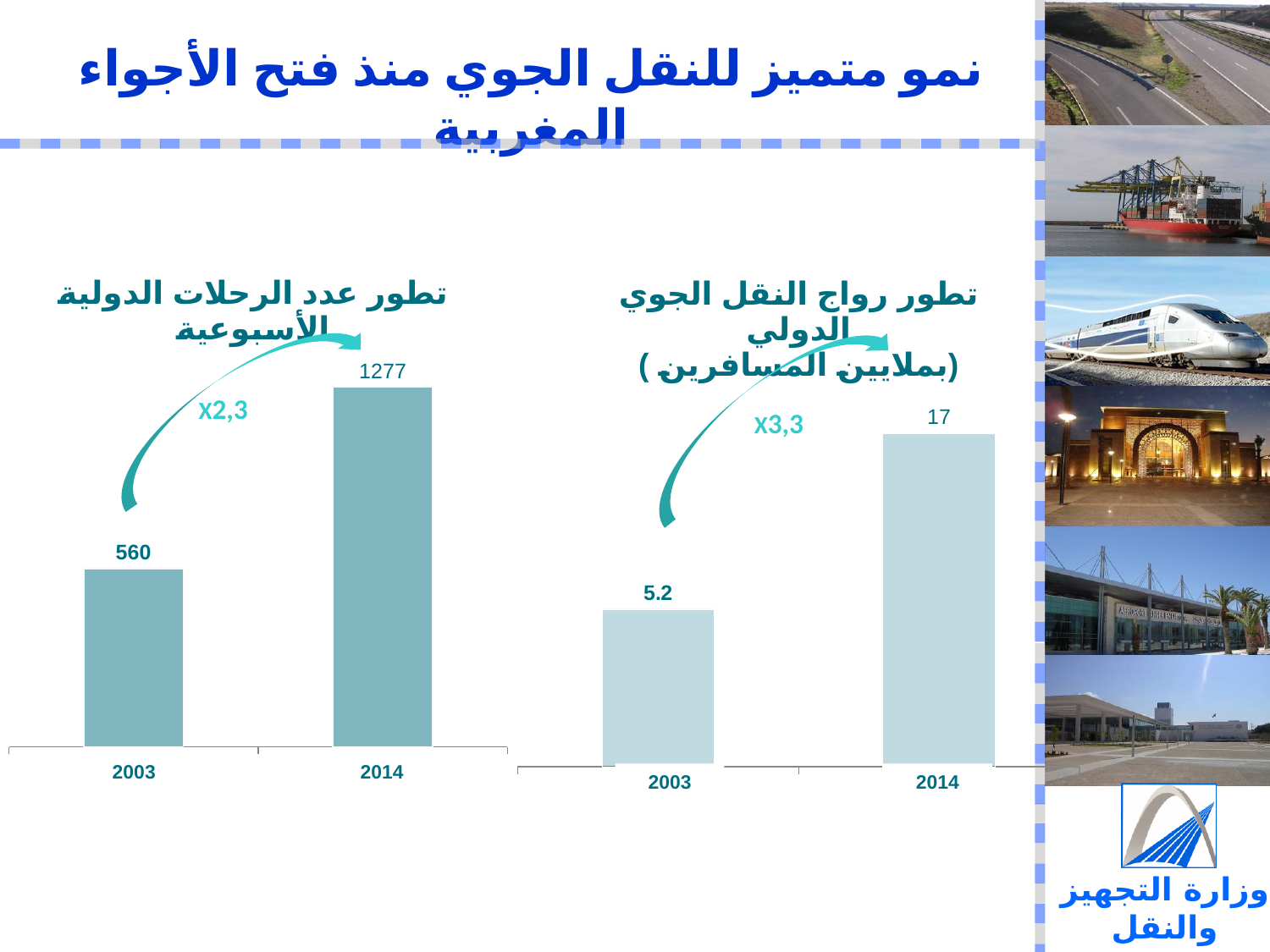
How many bars does the left chart have? 2 What type of chart is the right chart? Bar chart What growth multiplier is annotated on the left chart's arrow? X2,3 In the right chart, what is the difference between the 2014 and 2003 values? 11.8 In the left chart, which year has the higher value? 2014 In the right chart (international air traffic in millions of passengers), what is the value for 2003? 5.2 In the right chart, do the values rise or fall from 2003 to 2014? Rise In the right chart, which year has the lower value? 2003 In the right chart (international air traffic in millions of passengers), what is the value for 2014? 17 In the left chart (weekly international flights), what is the value for 2014? 1277 In the left chart, what is the difference between the 2014 and 2003 values? 717 In the left chart (weekly international flights), what is the value for 2003? 560